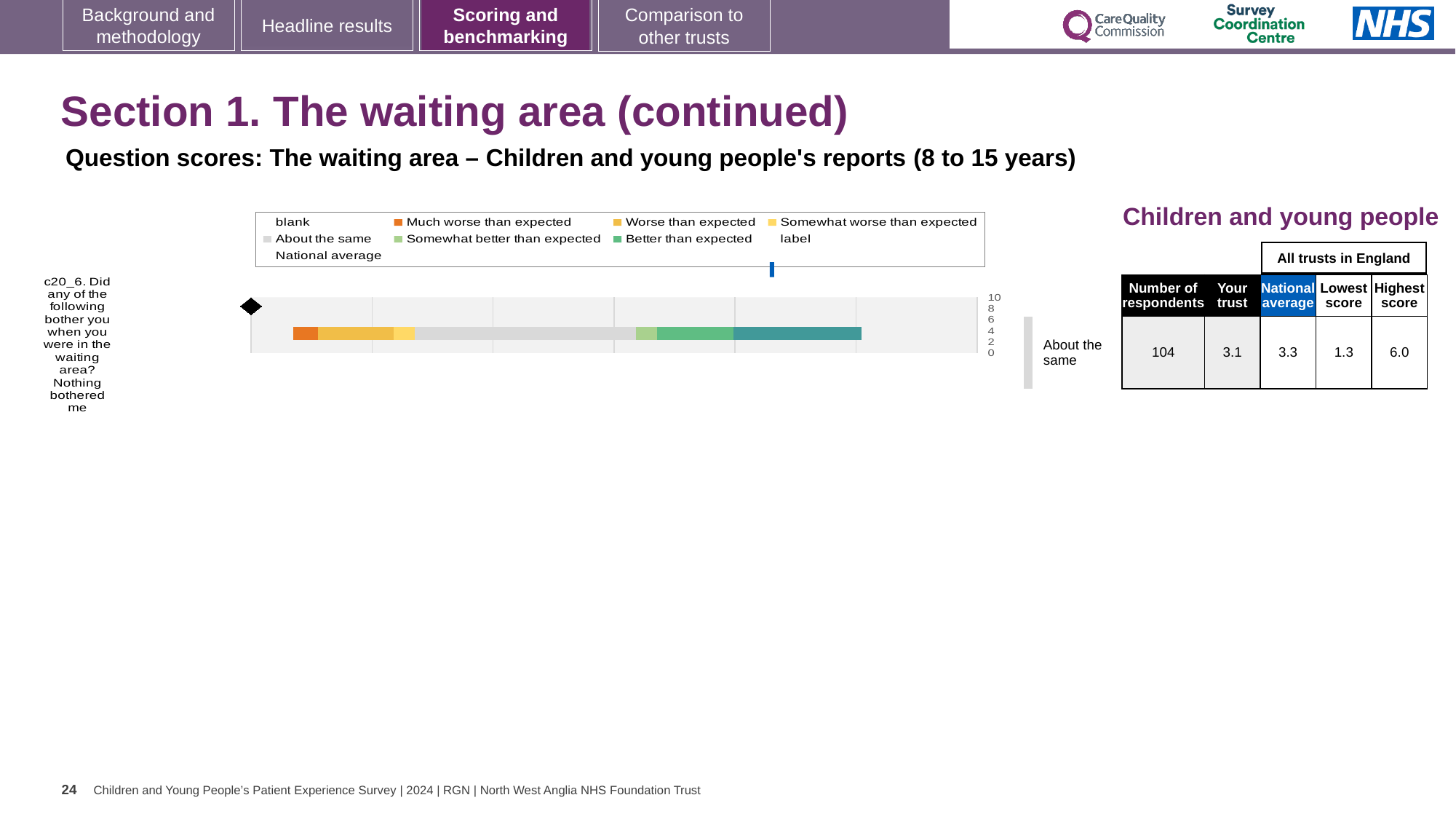
In the 'Children and young people' table, what is the difference between the highest score and the lowest score? 4.7 How many question categories are plotted in the chart? 1 What colour does the legend use for 'Much worse than expected'? orange In the 'Children and young people' table, what is the number of respondents for question c20_6? 104 In the 'Children and young people' table, what is the national average score? 3.3 In the 'Children and young people' table, is the 'Your trust' score larger or smaller than the national average? smaller How many entries does the chart legend list? 9 What rating label is shown to the right of the bar for question c20_6? About the same Which question code is plotted in the chart? c20_6 What kind of chart is shown on the slide? bar chart In the 'Children and young people' table, what is the highest score among all trusts in England? 6.0 In the 'Children and young people' table, what is the 'Your trust' score? 3.1